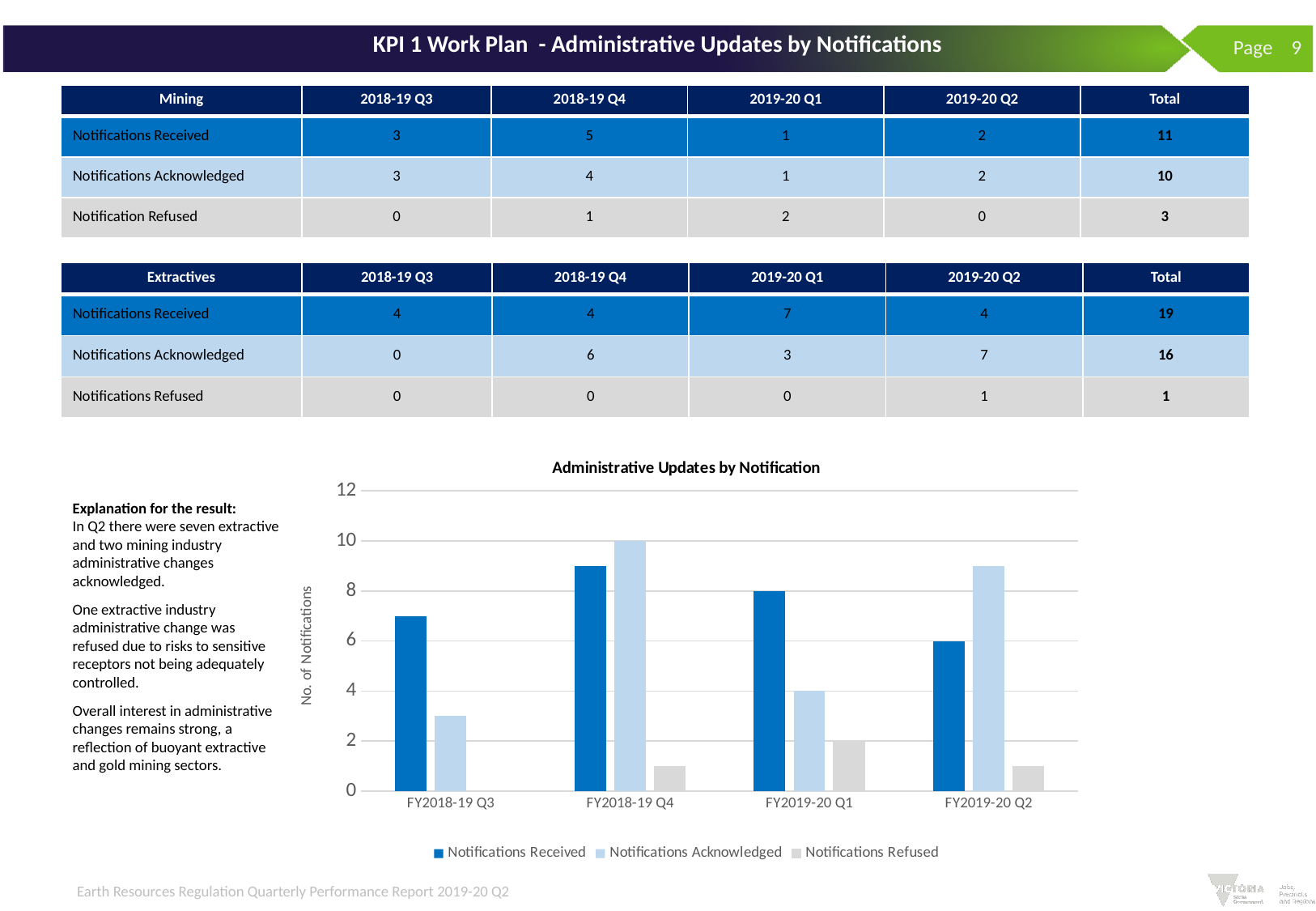
Is the value for Notifications Received in FY2018-19 Q3 greater or less than 6? greater What is the value for Notifications Acknowledged in FY2018-19 Q4? 10 What kind of chart is shown on the slide? bar chart What is the title of the chart? Administrative Updates by Notification What is the value for Notifications Received in FY2019-20 Q1? 8 Which is larger in FY2019-20 Q2: Notifications Received or Notifications Acknowledged? Notifications Acknowledged How many quarters are shown on the x axis of the chart? 4 What is the value for Notifications Received in FY2019-20 Q2? 6 What is the value for Notifications Acknowledged in FY2019-20 Q1? 4 What is the value for Notifications Refused in FY2019-20 Q1? 2 In which quarter is the Notifications Acknowledged bar the highest? FY2018-19 Q4 How many series does the chart legend list? 3